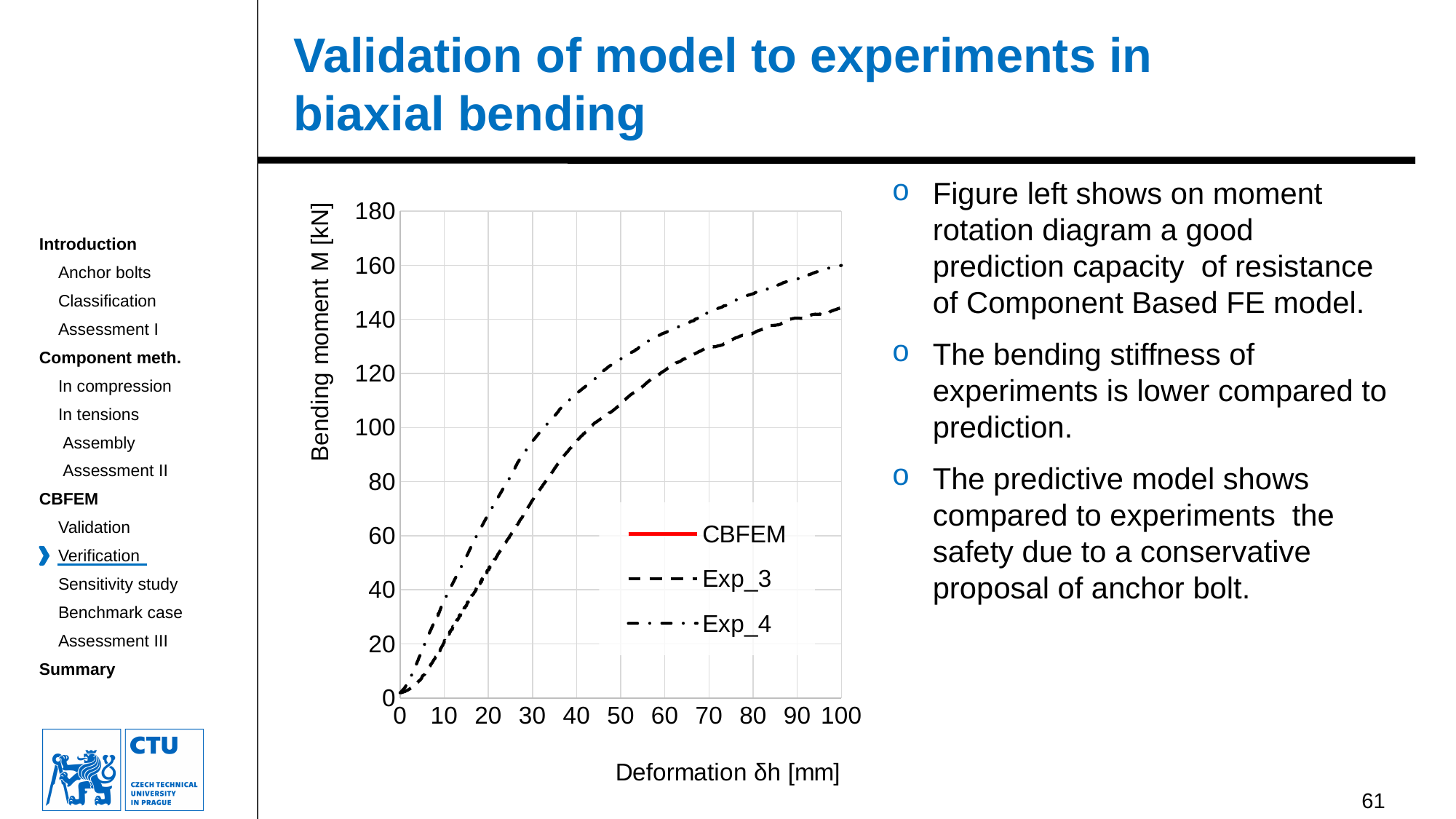
Is the Exp_3 value at a deformation of 100 mm greater or less than 120? greater Do the Exp_3 values rise or fall as deformation increases along the x axis? rise Is the Exp_3 value at a deformation of 50 mm greater or less than 100? greater At a deformation of 50 mm, which series has the larger bending moment, Exp_3 or Exp_4? Exp_4 Is the Exp_4 value at a deformation of 100 mm greater or less than 140? greater Which series are listed in the chart legend? CBFEM, Exp_3, Exp_4 What kind of chart is shown on the slide? line chart How many series does the chart legend list? 3 Do the Exp_4 values rise or fall as deformation increases along the x axis? rise What is the label of the vertical axis of the chart? Bending moment M [kN]